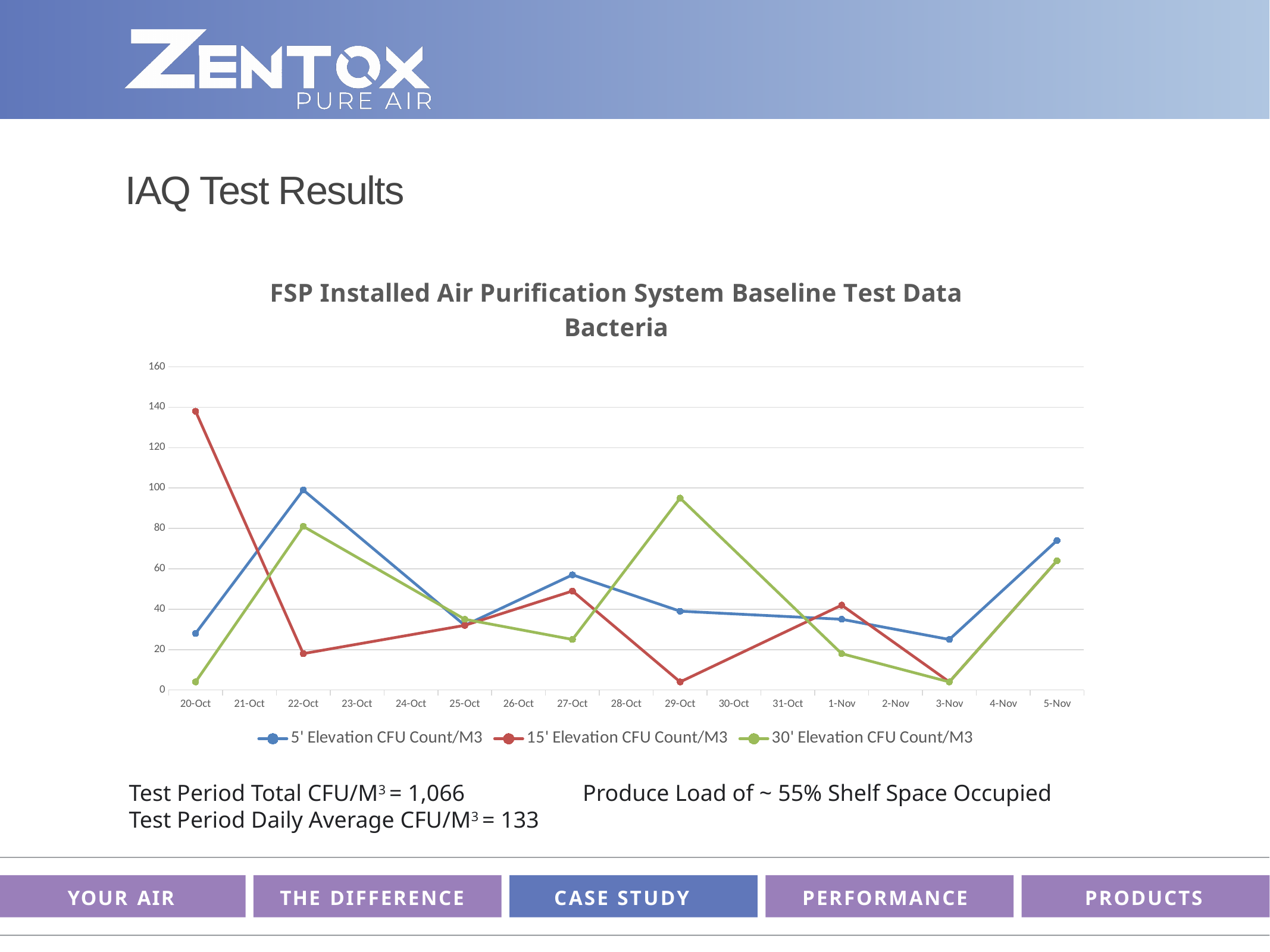
Is the value for 5' Elevation CFU Count/M3 on 22-Oct greater or less than 80? greater On 29-Oct, which series has the larger value: 30' Elevation CFU Count/M3 or 15' Elevation CFU Count/M3? 30' Elevation CFU Count/M3 Does the 15' Elevation CFU Count/M3 series rise or fall from 20-Oct to 22-Oct? fall On which date does the 30' Elevation CFU Count/M3 series reach its highest value? 29-Oct How many series does the legend list? 3 Is the value for 15' Elevation CFU Count/M3 on 20-Oct greater or less than 120? greater How many data points are plotted for each series? 8 On which date does the 15' Elevation CFU Count/M3 series reach its highest value? 20-Oct What kind of chart is shown on the slide? line chart What is the title of the chart? FSP Installed Air Purification System Baseline Test Data Bacteria Is the value for 15' Elevation CFU Count/M3 on 29-Oct greater or less than 20? less Which series is drawn in red? 15' Elevation CFU Count/M3